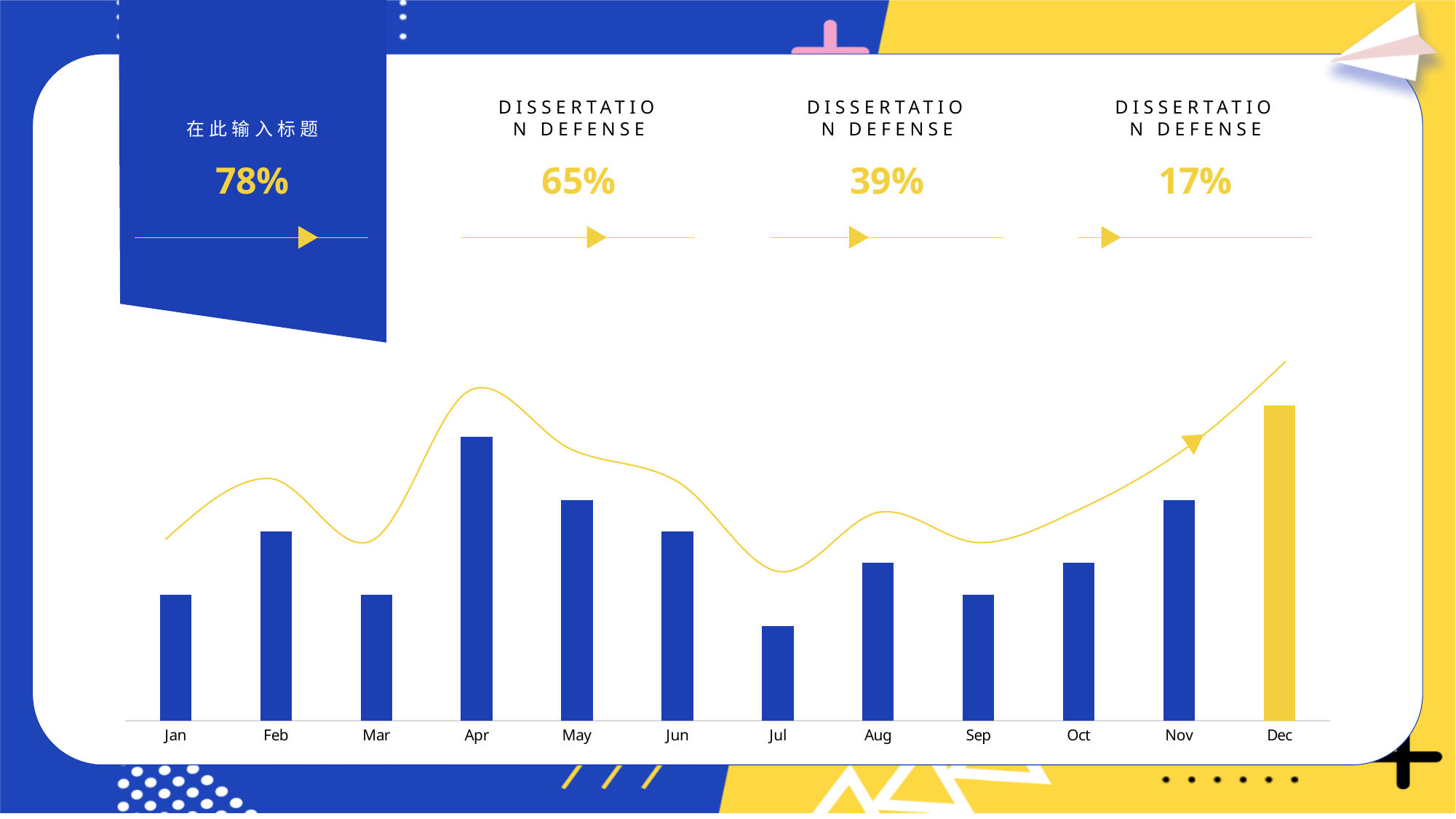
Which month has the tallest bar in the chart? Dec What is the first month label on the x axis of the chart? Jan Which month's bar is coloured yellow instead of blue? Dec Which bar is taller, Apr or May? Apr Which bar is taller, Oct or Nov? Nov Do the bars rise or fall from Sep to Dec? rise Which bar is taller, Aug or Sep? Aug What kind of chart is shown on the slide? bar chart How many months are shown on the x axis of the chart? 12 Do the bars rise or fall from Apr to Jul? fall Which month has the shortest bar in the chart? Jul